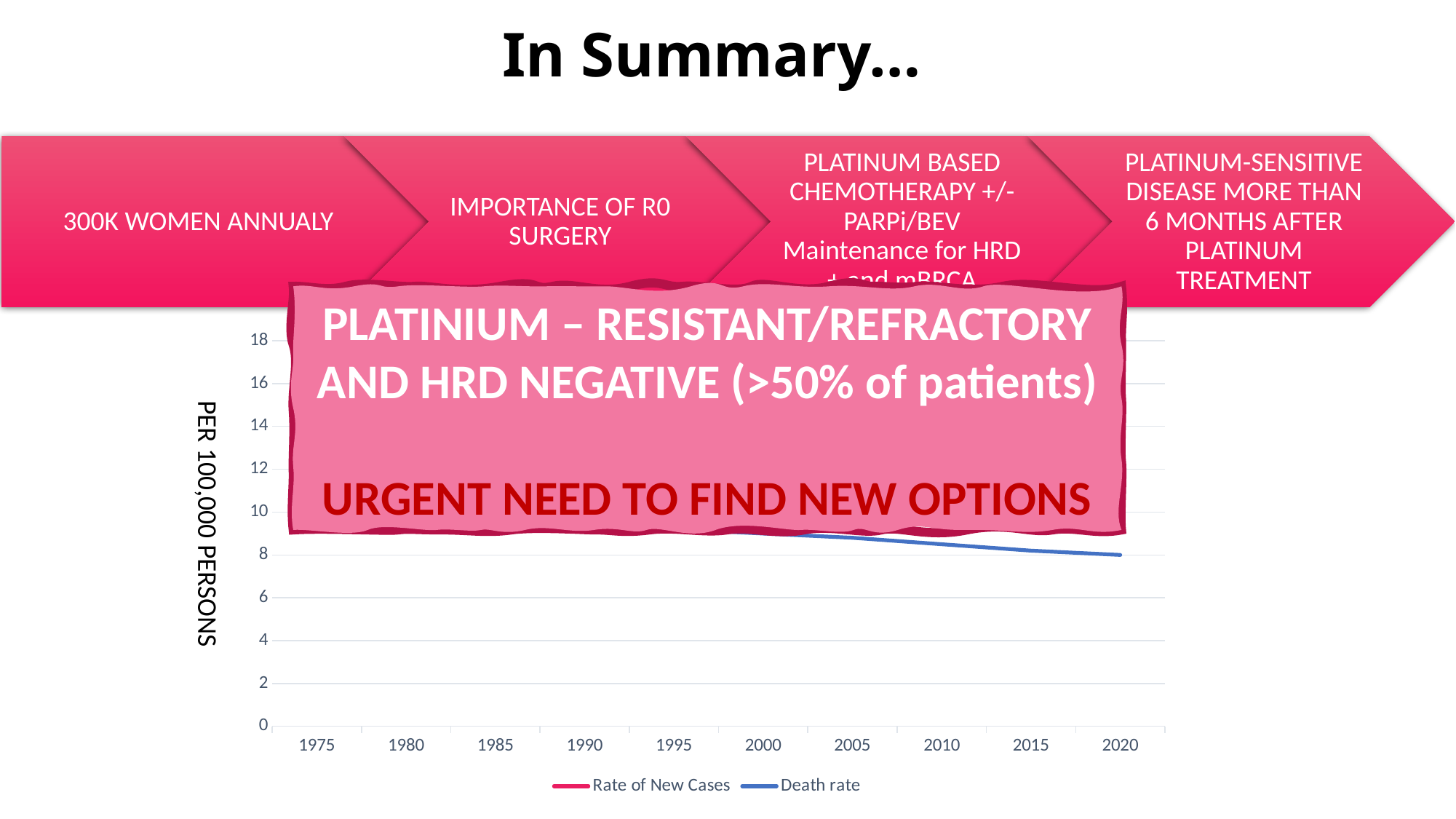
What kind of chart is shown on the slide? line chart Does the Death rate line rise or fall between 2000 and 2020? fall Is the Death rate value in 2020 greater or less than 6? greater What are the two series named in the chart's legend? Rate of New Cases and Death rate What is the label on the chart's vertical axis? PER 100,000 PERSONS What is the last year labelled on the chart's x axis? 2020 What is the first year labelled on the chart's x axis? 1975 How many series does the chart's legend list? 2 How many year labels are shown on the chart's x axis? 10 Is the Death rate value in 2020 greater or less than 10? less What is the highest value labelled on the chart's vertical axis? 18 Is the Death rate value in 2005 greater or less than 12? less